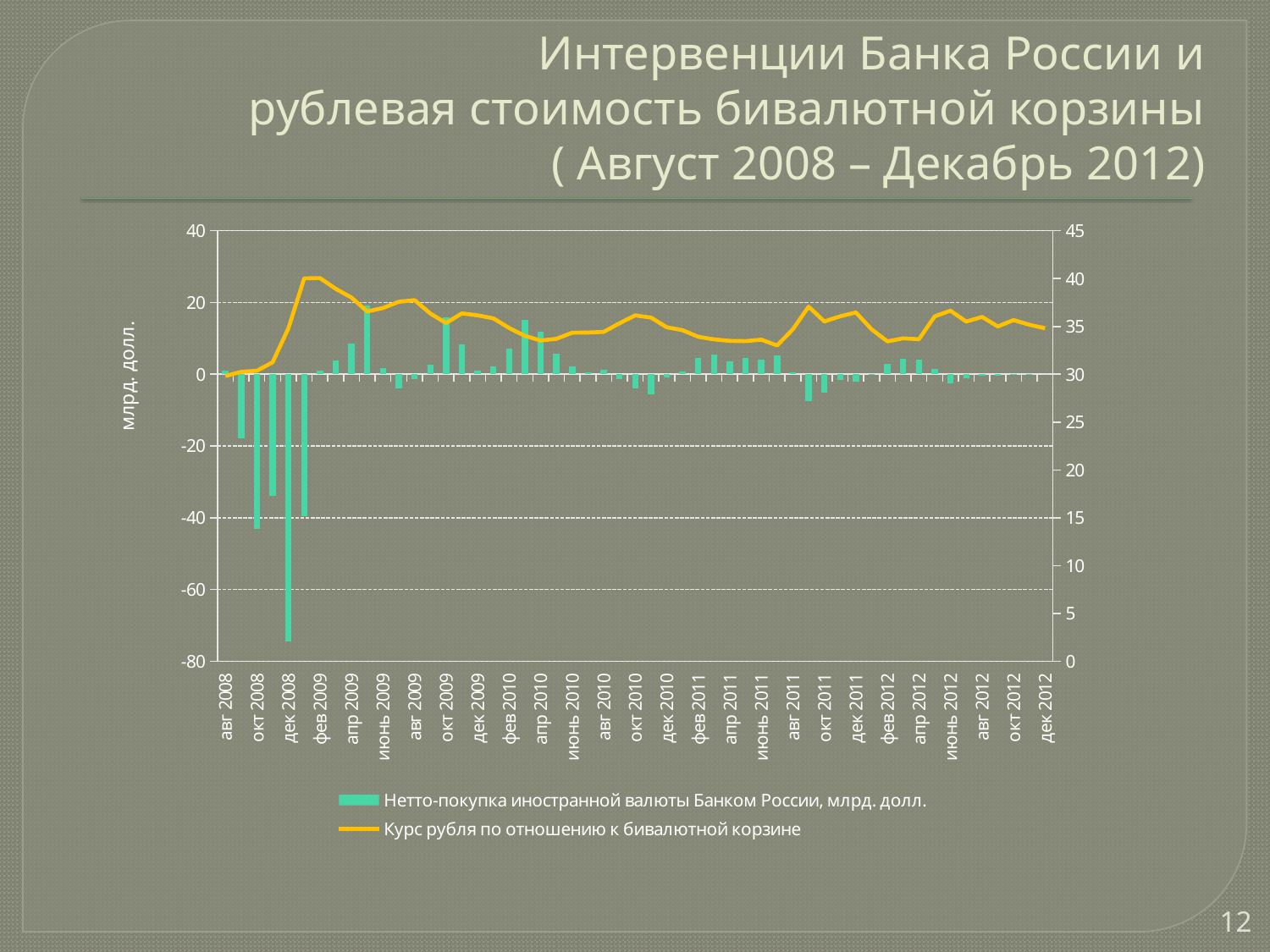
What is the label of the left vertical axis? млрд. долл. Is the net purchase bar for окт 2008 greater or less than -20 billion dollars? less Which is higher, the ruble rate line in окт 2008 or in фев 2009? фев 2009 How many series does the legend list? 2 Is the ruble rate against the bi-currency basket in апр 2009 greater or less than 35? greater What type of chart is shown on the slide? Combined bar and line chart What colour are the bars for net purchase of foreign currency by the Bank of Russia? Green Which month has the lowest (most negative) bar for net purchase of foreign currency? дек 2008 Does the ruble rate line rise or fall from авг 2008 to фев 2009? rise Is the net purchase bar for дек 2008 greater or less than -60 billion dollars? less Which is lower, the net purchase bar for окт 2008 or for дек 2008? дек 2008